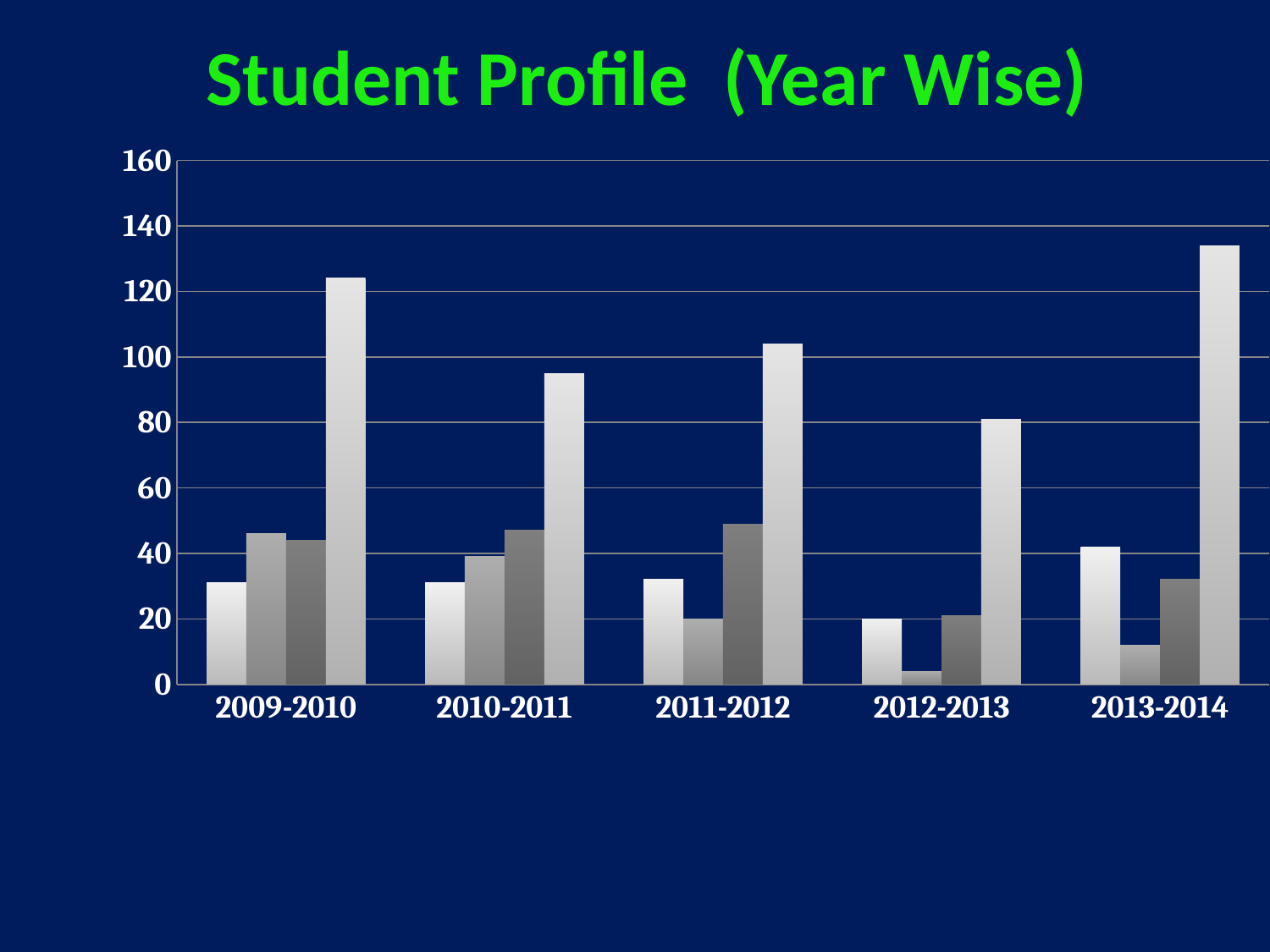
Which year has the taller tallest bar, 2009-2010 or 2010-2011? 2009-2010 In 2012-2013, which is taller, the first bar or the second bar? The first bar Which year category contains the shortest bar on the chart? 2012-2013 Is the tallest bar for 2011-2012 greater or less than 80? greater Is the tallest bar for 2012-2013 greater or less than 100? less Is the tallest bar for 2013-2014 greater or less than 120? greater How many year categories are shown on the x axis? 5 Which year category contains the tallest bar on the chart? 2013-2014 How many bars are plotted for each year category? 4 What kind of chart is shown on the slide? Bar chart What is the title of the chart? Student Profile (Year Wise)